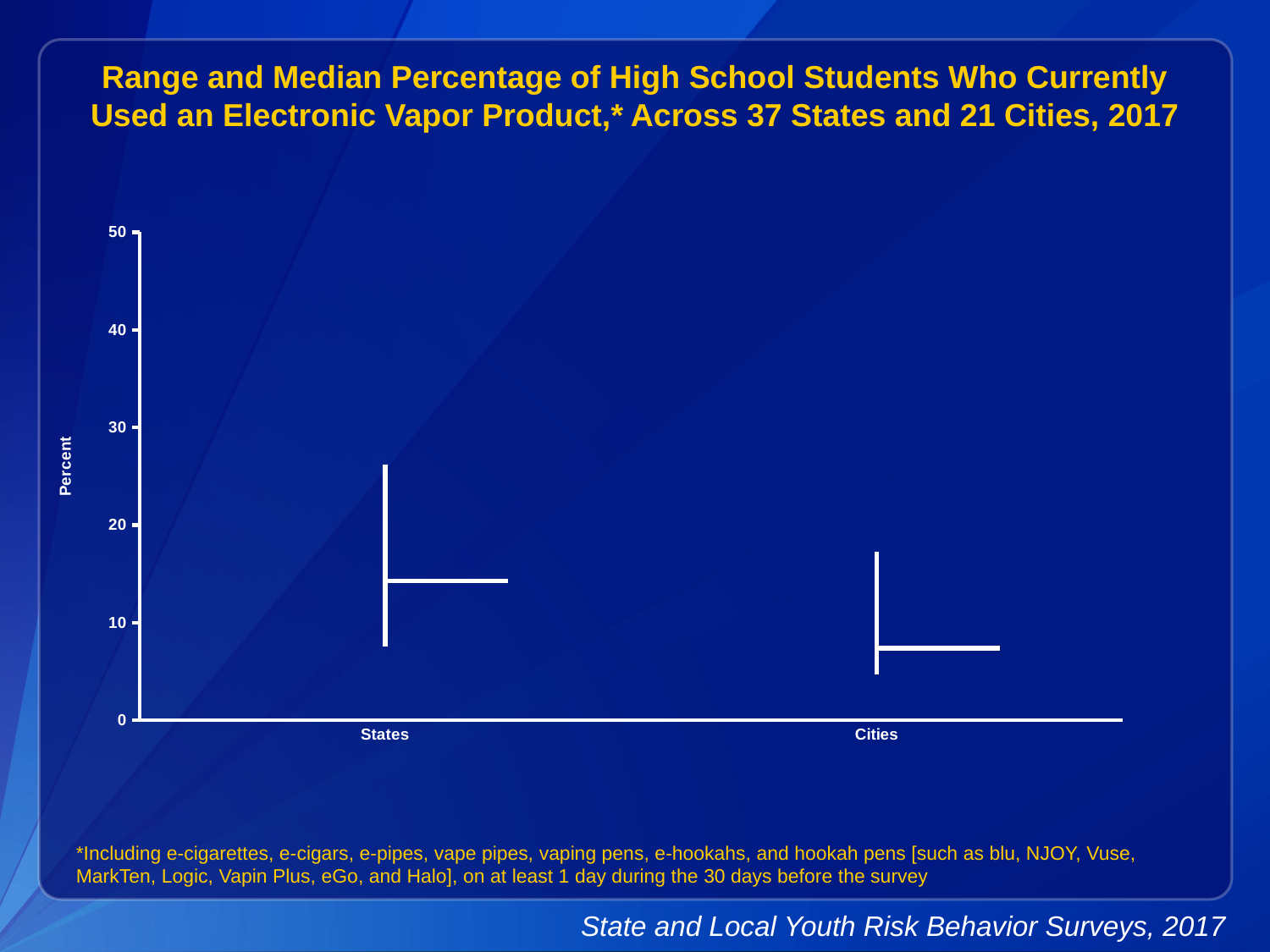
What is the label of the y axis? Percent Which category has the higher top of its range, States or Cities? States Is the median value for States greater or less than 10? greater What are the two categories shown on the x axis? States and Cities How many categories are shown on the x axis of the chart? 2 Which category has the higher median percentage, States or Cities? States Is the bottom of the range for States greater or less than 10? less Is the top of the range for Cities greater or less than 20? less What is the highest value shown on the y axis? 50 Which category has the lower bottom of its range, States or Cities? Cities